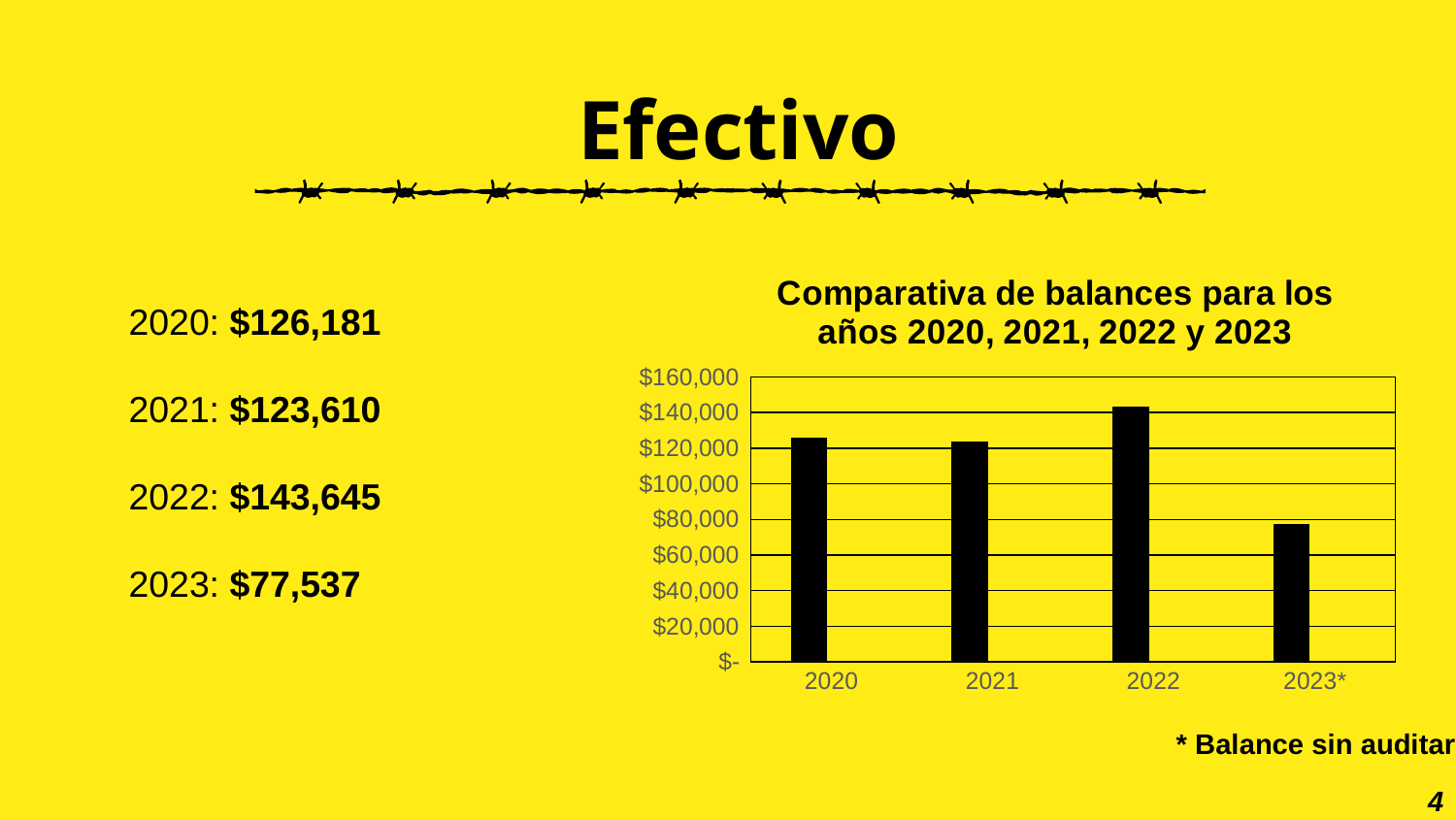
Is the value for 2022 greater or less than $140,000? greater What is the balance for 2022? $143,645 Which year has the highest balance in the chart? 2022 What type of chart is shown on the slide? bar chart Which year has the lowest balance in the chart? 2023* What is the balance for 2021? $123,610 What is the balance for 2023? $77,537 What is the title of the chart? Comparativa de balances para los años 2020, 2021, 2022 y 2023 How many years are plotted on the chart? 4 What is the difference between the balances for 2022 and 2023? $66,108 Is the value for 2023* greater or less than $80,000? less Does the balance rise or fall from 2022 to 2023? fall